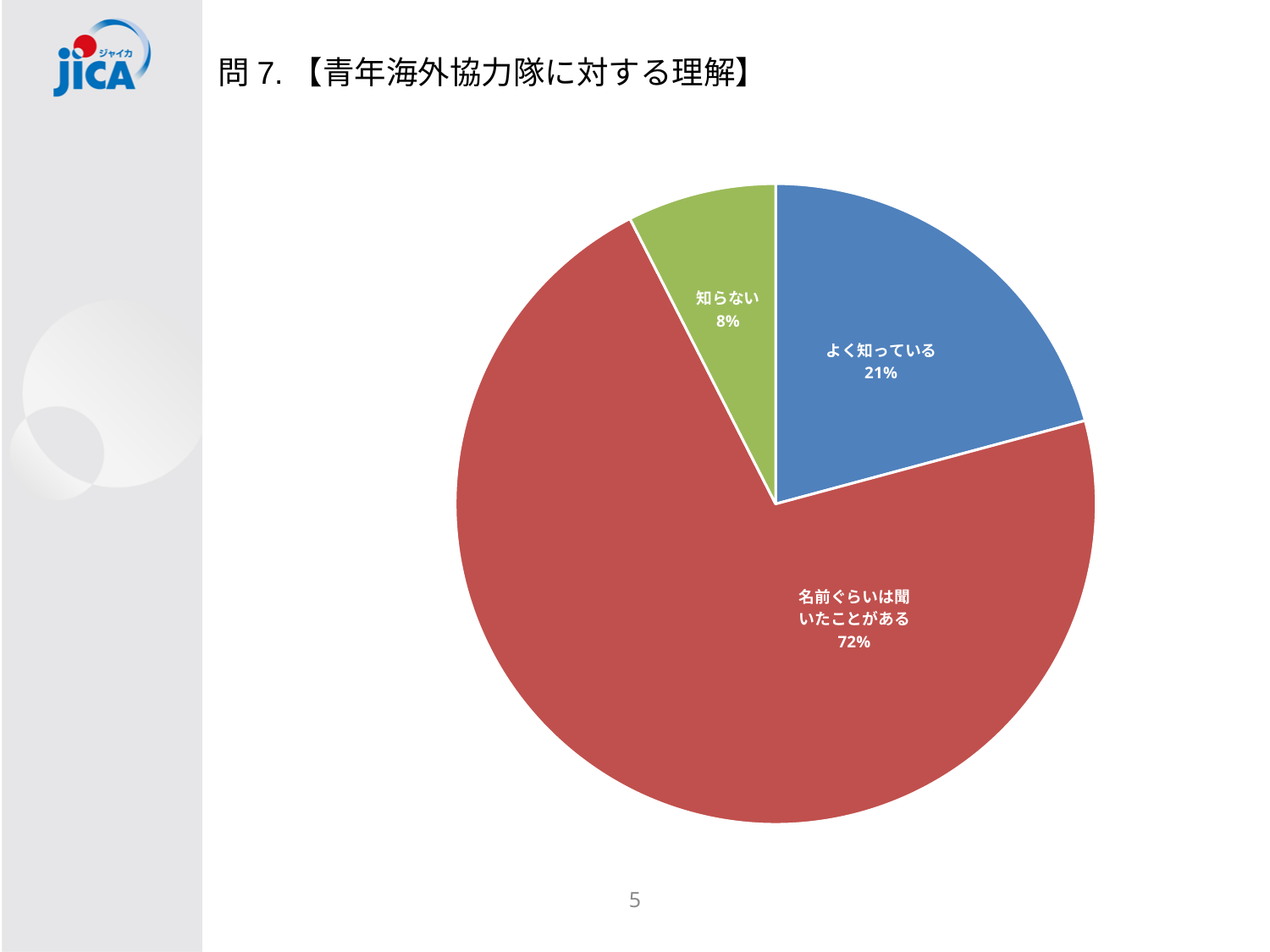
What kind of chart is shown on the slide? pie chart What share of the pie does 「よく知っている」 represent? 21% How many slices does the pie chart have? 3 What colour is the slice for 「知らない」? green What is the title of the slide containing the pie chart? 問 7. 【青年海外協力隊に対する理解】 Which category has the largest slice of the pie? 名前ぐらいは聞いたことがある What is the difference in percentage points between 「よく知っている」 and 「知らない」? 13 What share of the pie does 「知らない」 represent? 8% What is the difference in percentage points between 「名前ぐらいは聞いたことがある」 and 「よく知っている」? 51 Which is larger, the slice for 「よく知っている」 or the slice for 「知らない」? よく知っている Which category has the smallest slice of the pie? 知らない What share of the pie does 「名前ぐらいは聞いたことがある」 represent? 72%